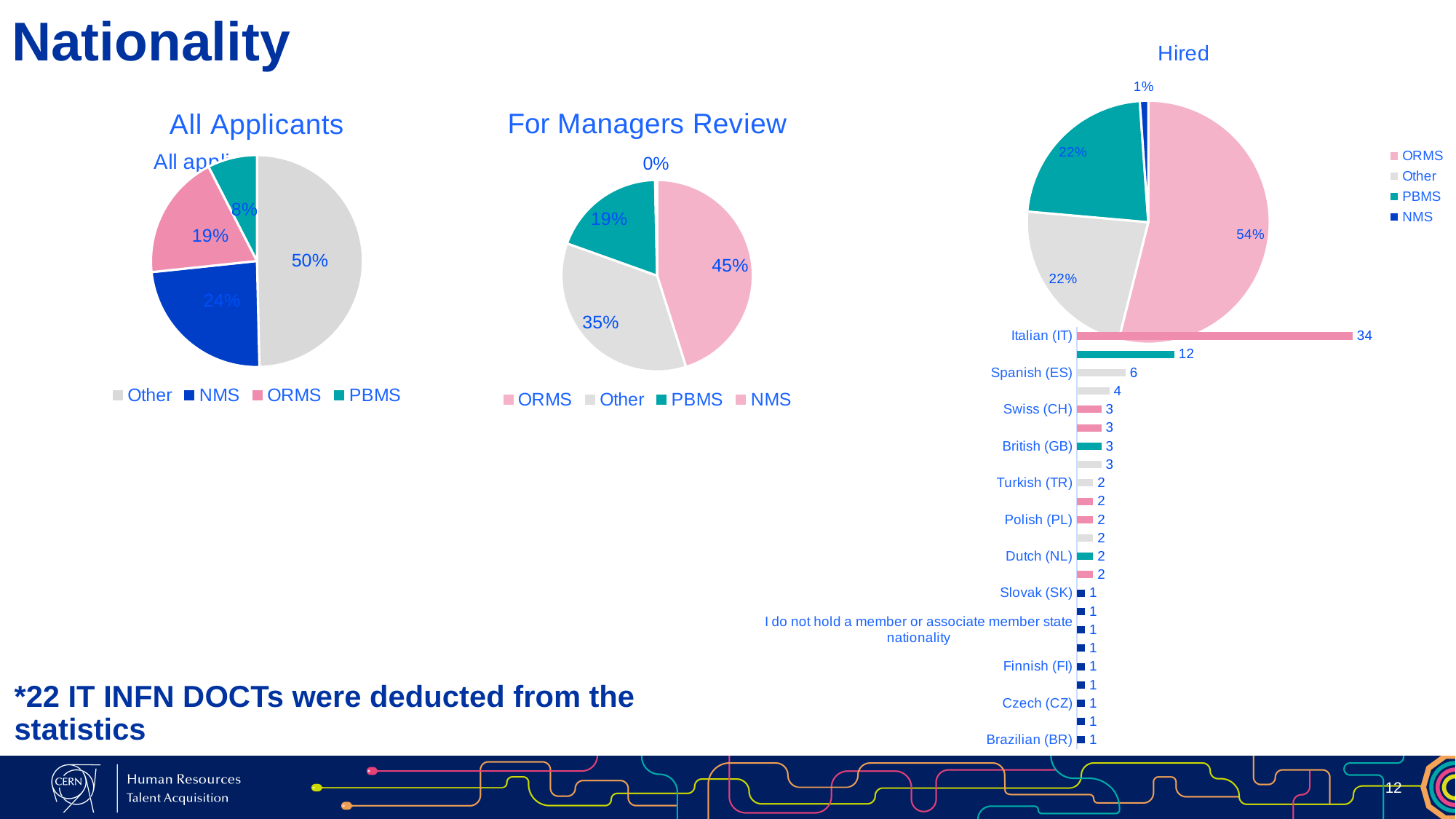
In the For Managers Review pie chart, which category has the largest share? ORMS In the All Applicants pie chart, how many percentage points larger is Other than NMS? 26 In the Hired pie chart, what share is labelled for ORMS? 54% In the bar chart of nationalities at the bottom right, what is the value for Italian (IT)? 34 In the bar chart of nationalities at the bottom right, what is the difference between the values for Italian (IT) and Spanish (ES)? 28 In the For Managers Review pie chart, what share is labelled for ORMS? 45% How many entries does the legend of the All Applicants chart list? 4 In the For Managers Review pie chart, what share is labelled for NMS? 0% In the All Applicants pie chart, what share is labelled for NMS? 24% In the Hired pie chart, what share is labelled for NMS? 1% In the All Applicants pie chart, which category has the smallest share? PBMS In the All Applicants pie chart, what share is labelled for Other? 50%